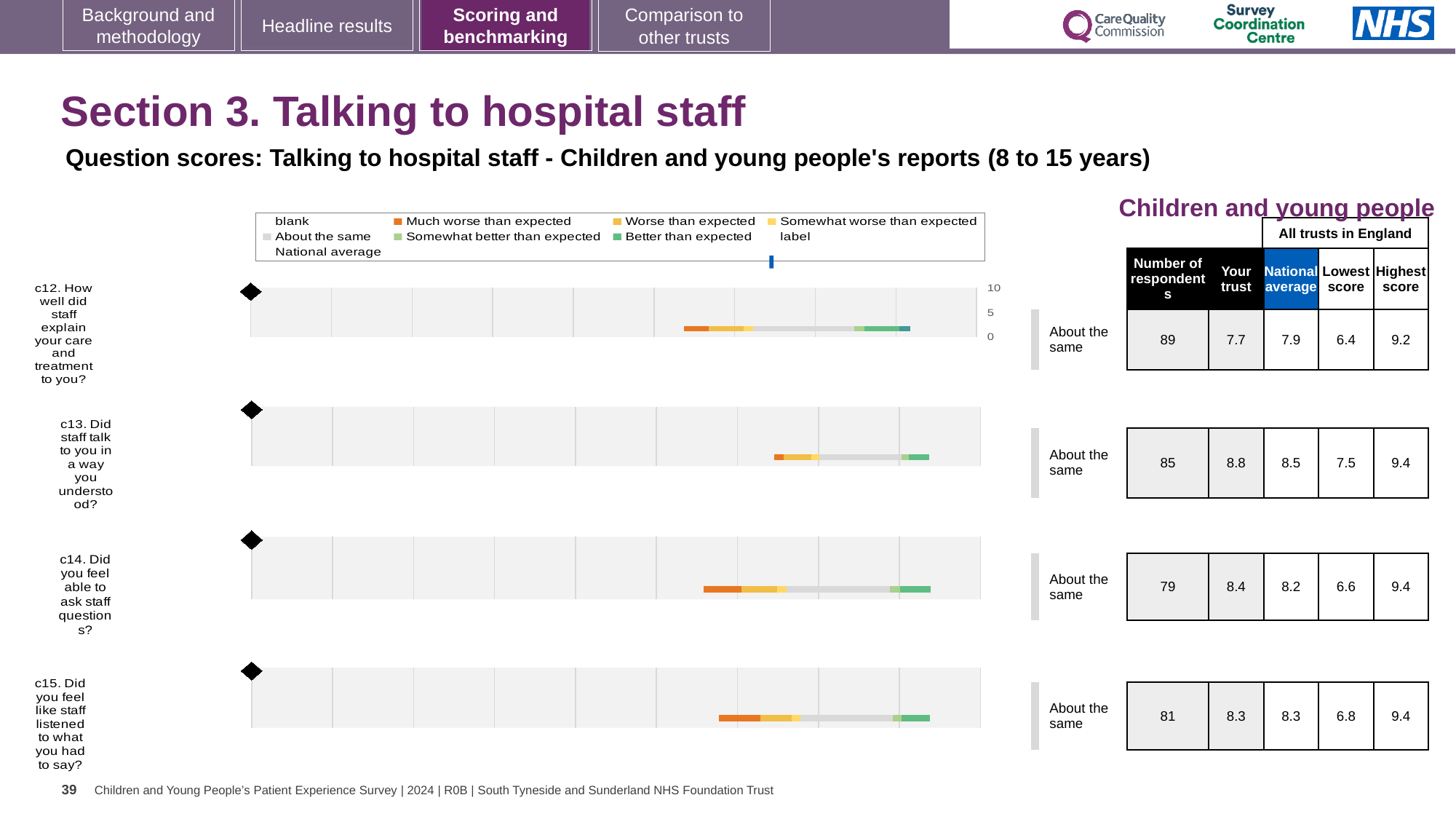
How many questions (c12 to c15) are plotted on the slide? 4 For c14, is the 'Your trust' score or the national average larger? Your trust For c12 (How well did staff explain your care and treatment to you?), what is the 'Your trust' score shown in the table? 7.7 For c13 (Did staff talk to you in a way you understood?), what is the national average shown in the table? 8.5 For c14 (Did you feel able to ask staff questions?), how many respondents are shown in the table? 79 What kind of chart is used for each question (c12 to c15) on the slide? bar chart For c13, what is the difference between the 'Your trust' score and the national average? 0.3 What is the highest score across all trusts in England for c12? 9.2 Which question has the highest 'Your trust' score in the table? c13. Did staff talk to you in a way you understood? What benchmark category is shown next to each of the four question charts? About the same Which question has the lowest 'Your trust' score in the table? c12. How well did staff explain your care and treatment to you? For c15 (Did you feel like staff listened to what you had to say?), what is the lowest score across all trusts in England? 6.8